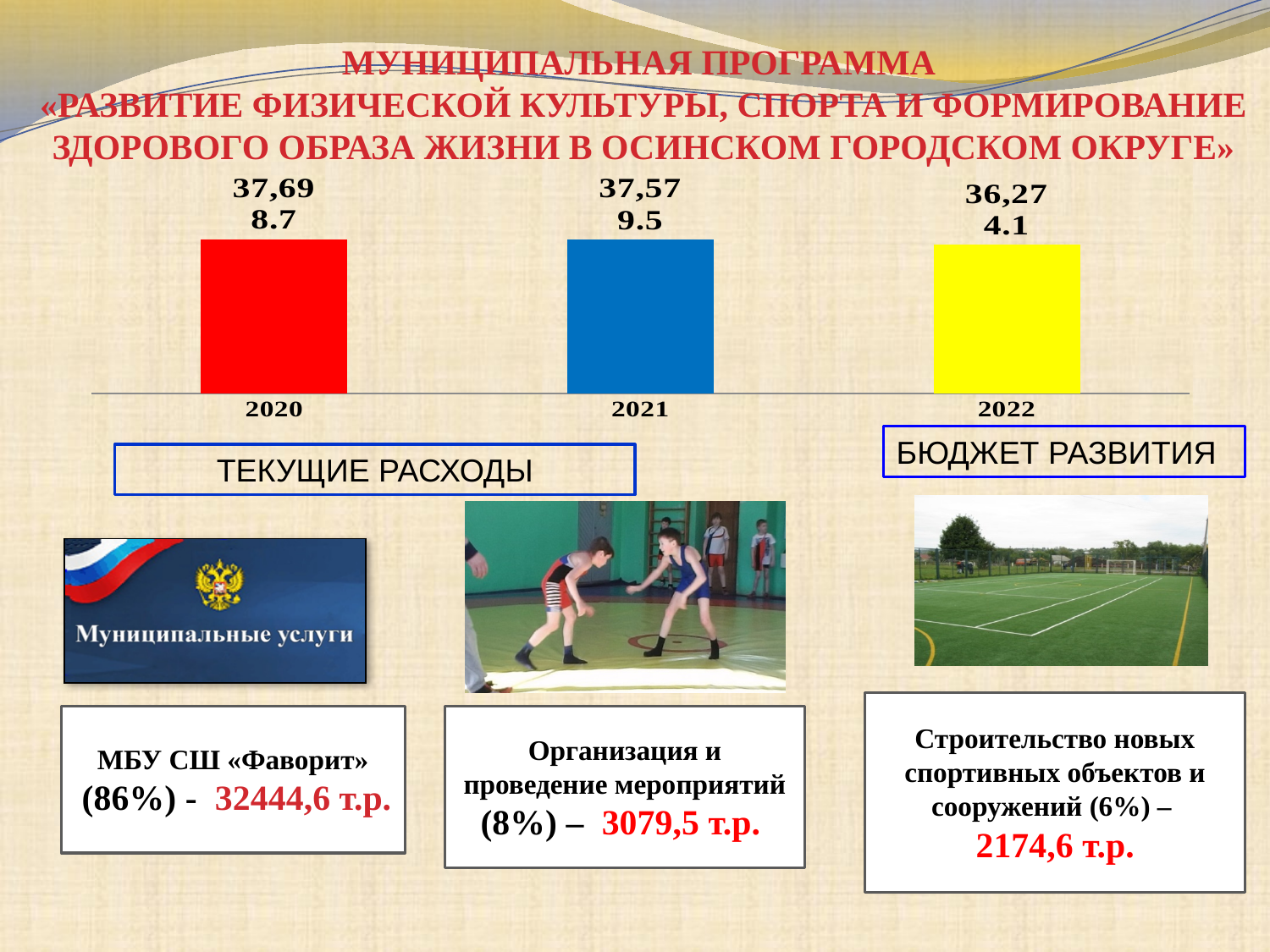
How many bars (years) does the chart show? 3 What colour is the bar for 2021? blue Do the upper printed values (37,69; 37,57; 36,27) rise or fall from 2020 to 2022? fall What is the lower value printed above the 2021 bar? 9.5 What is the upper value printed above the 2022 bar? 36,27 What is the upper value printed above the 2020 bar? 37,69 What kind of chart is shown on the slide? bar chart What is the lower value printed above the 2022 bar? 4.1